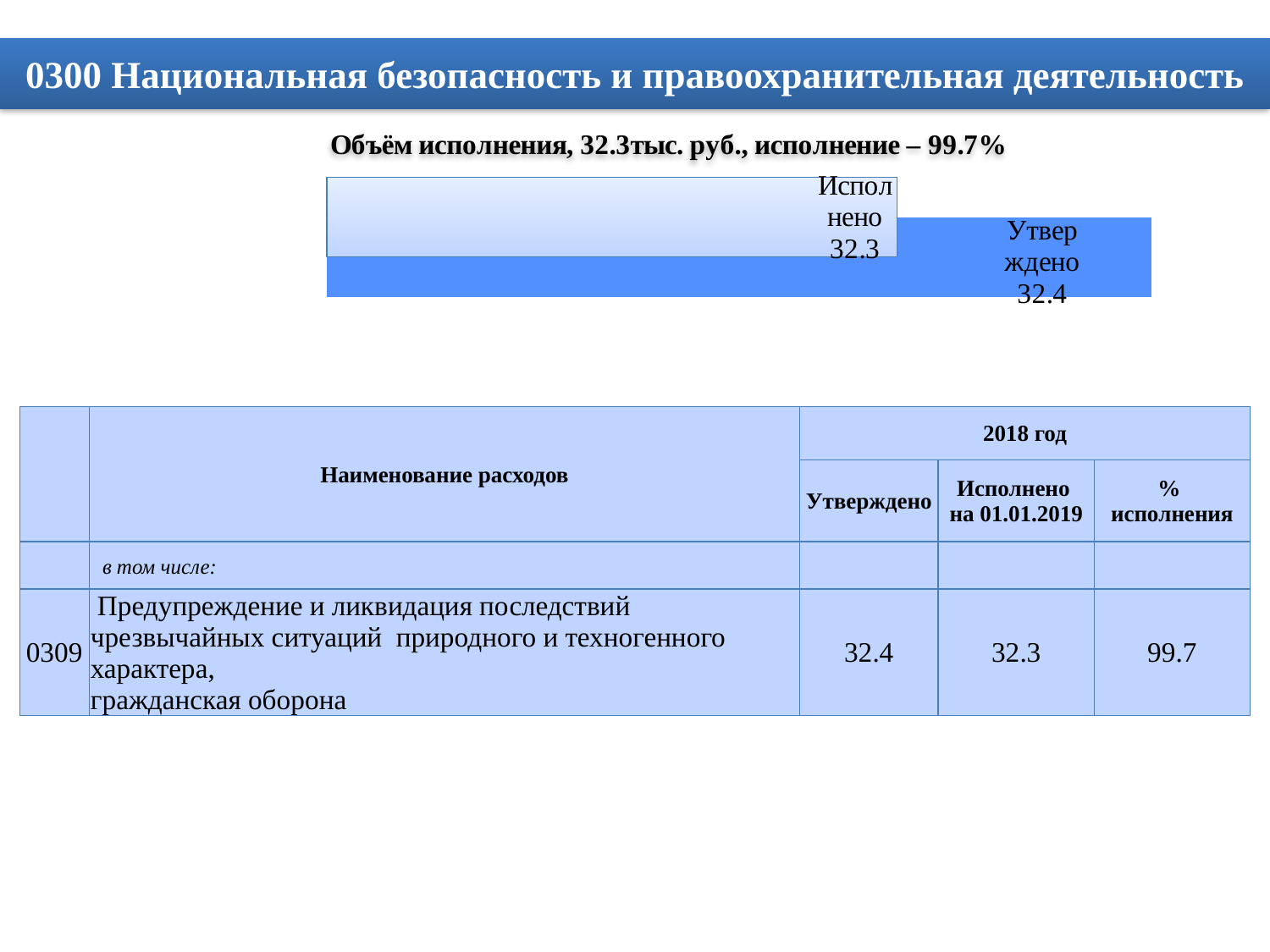
Which bar shows the lowest value? Исполнено What is the difference between the Утверждено value and the Исполнено value? 0.1 What is the title printed above the chart? Объём исполнения, 32.3тыс. руб., исполнение – 99.7% What value is shown for the bar labelled Утверждено? 32.4 What colour is the Утверждено bar? blue How many bars are plotted in the chart? 2 Which bar shows the highest value? Утверждено What type of chart is shown on the slide? bar chart Which bar has the higher value, Исполнено or Утверждено? Утверждено What value is shown for the bar labelled Исполнено? 32.3